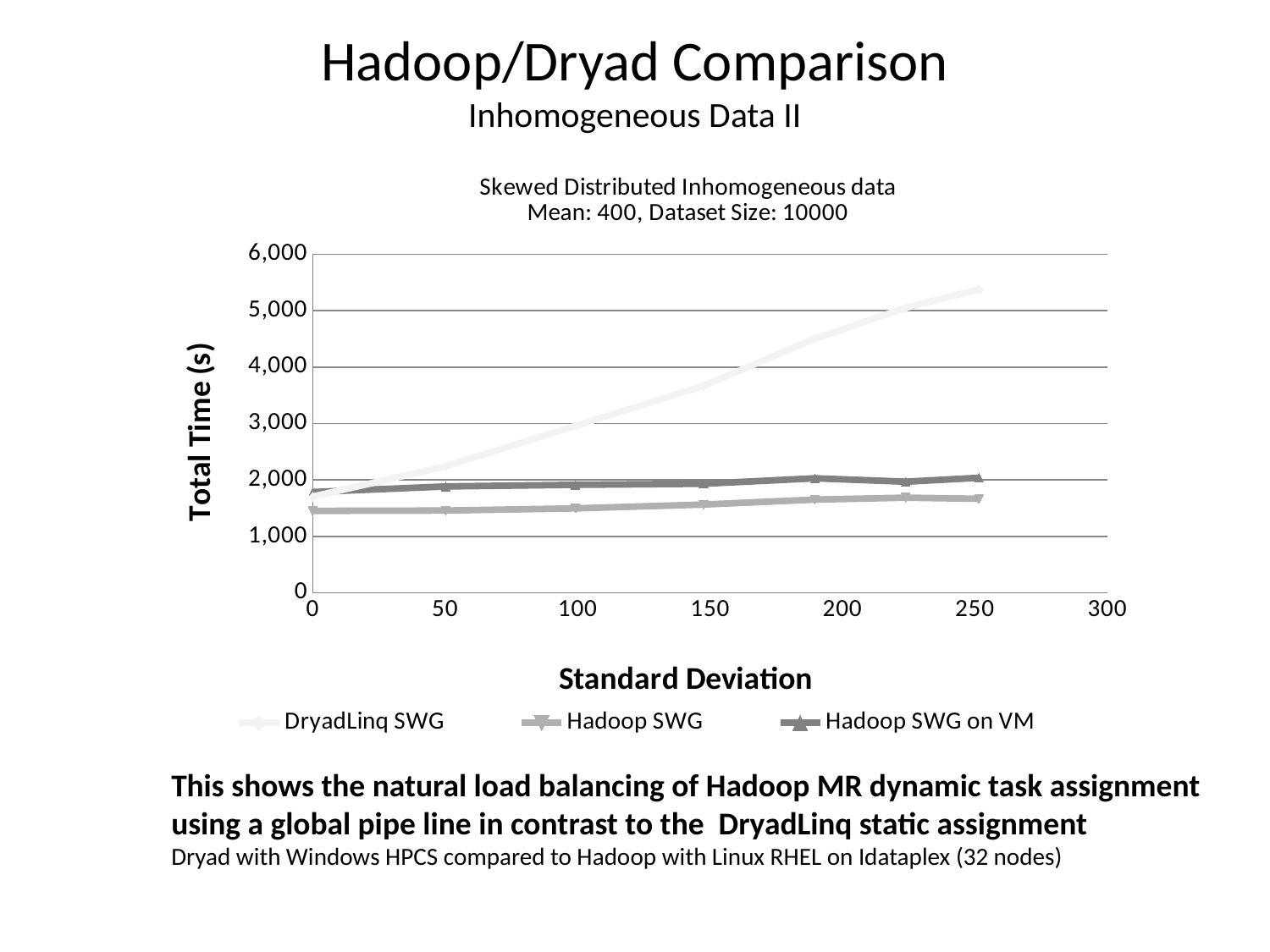
What kind of chart is shown on the slide? line chart Does the DryadLinq SWG series rise or fall as standard deviation increases? rise Is the value for Hadoop SWG on VM at standard deviation 150 greater or less than 3,000? less Is the value for DryadLinq SWG at standard deviation 100 greater or less than 2,000? greater How many series does the legend list? 3 Which series has the lowest value at standard deviation 200? Hadoop SWG Which series has the highest value at standard deviation 250? DryadLinq SWG What is the title of the chart? Skewed Distributed Inhomogeneous data Mean: 400, Dataset Size: 10000 Is the value for DryadLinq SWG at standard deviation 250 greater or less than 5,000? greater At standard deviation 150, which is larger: DryadLinq SWG or Hadoop SWG on VM? DryadLinq SWG What is the label of the y axis? Total Time (s)